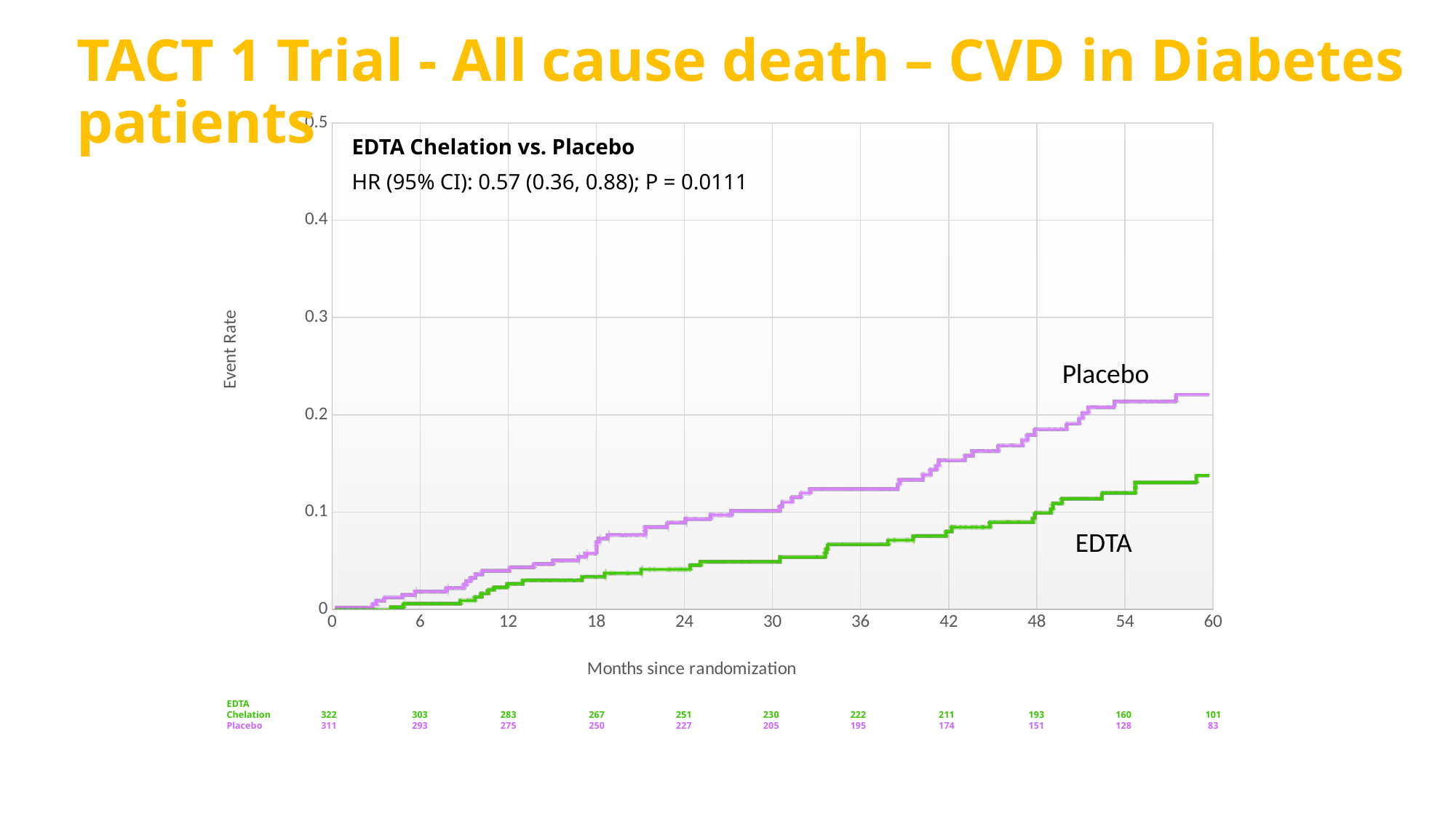
Is the EDTA event rate at 36 months greater or less than 0.1? less What is the 95% confidence interval for the hazard ratio shown on the chart? (0.36, 0.88) Is the Placebo event rate at 60 months greater or less than 0.2? greater Do the event rate curves rise or fall as months since randomization increase? Rise What P value is shown on the chart? 0.0111 How many Placebo patients were at risk at month 60? 83 What is the hazard ratio (HR) for EDTA Chelation vs. Placebo shown on the chart? 0.57 What is the difference between the number of EDTA Chelation patients and Placebo patients at risk at month 30? 25 How many series (treatment groups) are plotted in the chart? 2 How many EDTA Chelation patients were at risk at month 0? 322 Which group has the higher event rate at 60 months, Placebo or EDTA? Placebo What type of chart is shown on the slide? Line chart